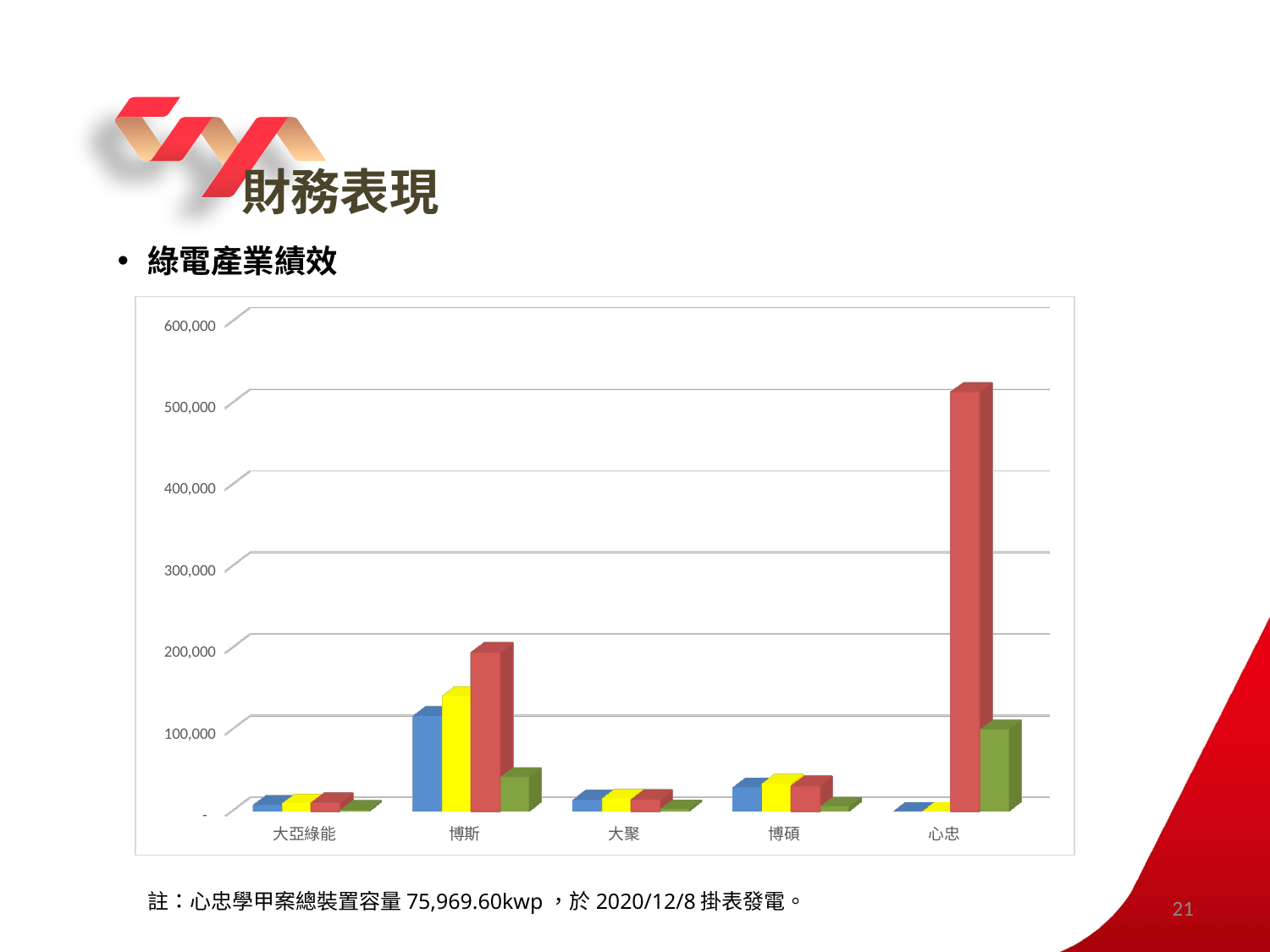
Which is larger, the blue bar for 博斯 or the blue bar for 大聚? 博斯 How many categories are shown on the x axis of the chart? 5 Which is larger, the red bar for 博斯 or the red bar for 心忠? 心忠 Is the value of the red bar for 心忠 greater or less than 400,000? greater Which category has the tallest bar in the chart? 心忠 Is the value of the red bar for 大聚 greater or less than 100,000? less What is the highest value shown on the chart's vertical axis? 600,000 What kind of chart is shown on the slide? bar chart Is the value of the blue bar for 博斯 greater or less than 200,000? less What is the label of the first category on the x axis of the chart? 大亞綠能